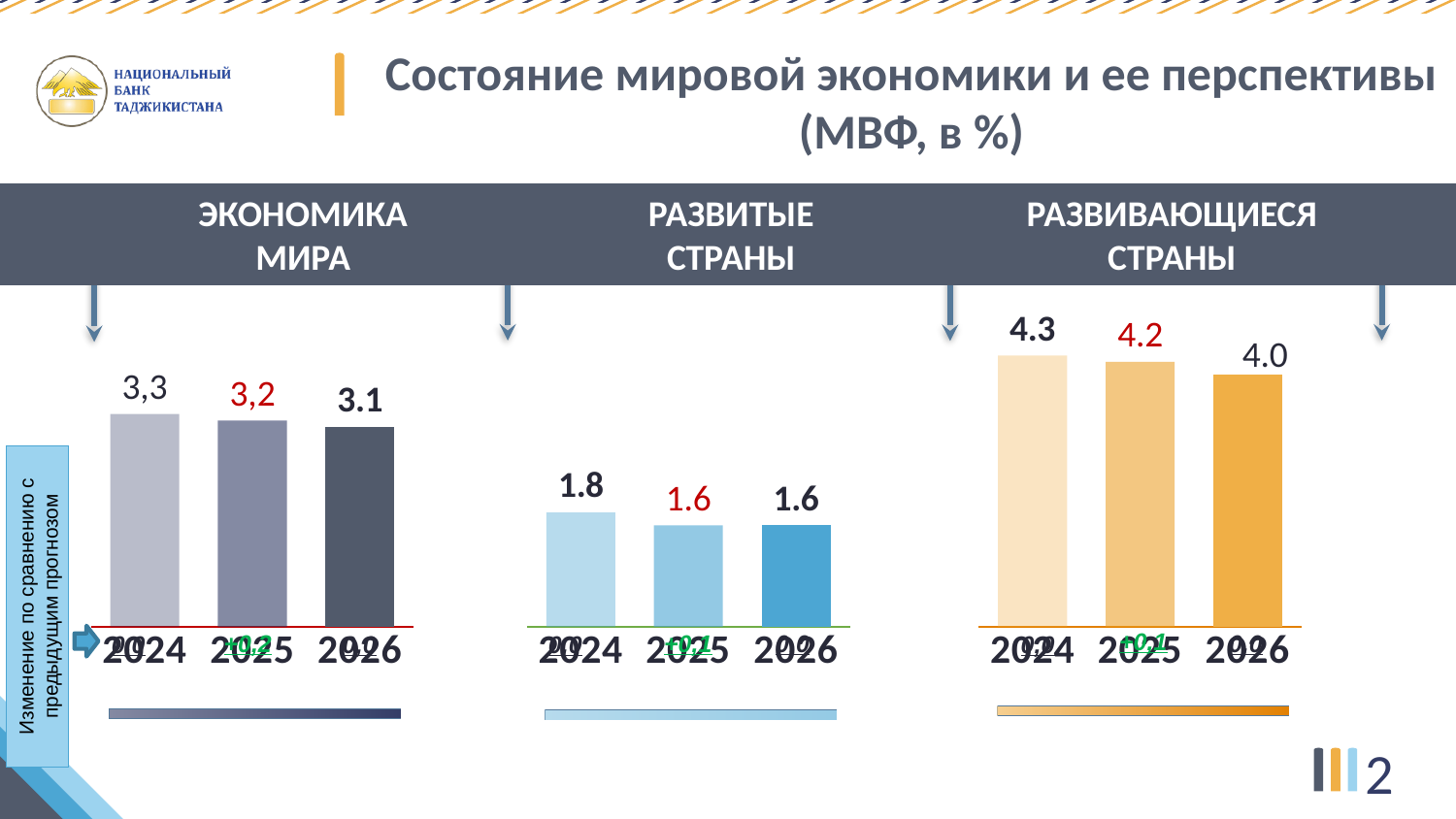
In the ЭКОНОМИКА МИРА chart, which year has the lowest value? 2026 In the РАЗВИТЫЕ СТРАНЫ chart, what is the difference between the 2024 and 2025 values? 0.2 How many years are shown in the РАЗВИВАЮЩИЕСЯ СТРАНЫ chart? 3 In the РАЗВИТЫЕ СТРАНЫ chart, is the value for 2024 larger or smaller than the value for 2026? larger In the РАЗВИВАЮЩИЕСЯ СТРАНЫ chart, what is the value for 2025? 4.2 What kind of chart is the РАЗВИТЫЕ СТРАНЫ chart? bar chart In the РАЗВИТЫЕ СТРАНЫ chart, what is the value for 2024? 1.8 In the ЭКОНОМИКА МИРА chart, do the values rise or fall from 2024 to 2026? fall In the РАЗВИВАЮЩИЕСЯ СТРАНЫ chart, which year has the highest value? 2024 In the РАЗВИВАЮЩИЕСЯ СТРАНЫ chart, what is the difference between the 2024 and 2026 values? 0.3 In the ЭКОНОМИКА МИРА chart, what is the value for 2026? 3.1 In the ЭКОНОМИКА МИРА chart, what is the value for 2024? 3,3